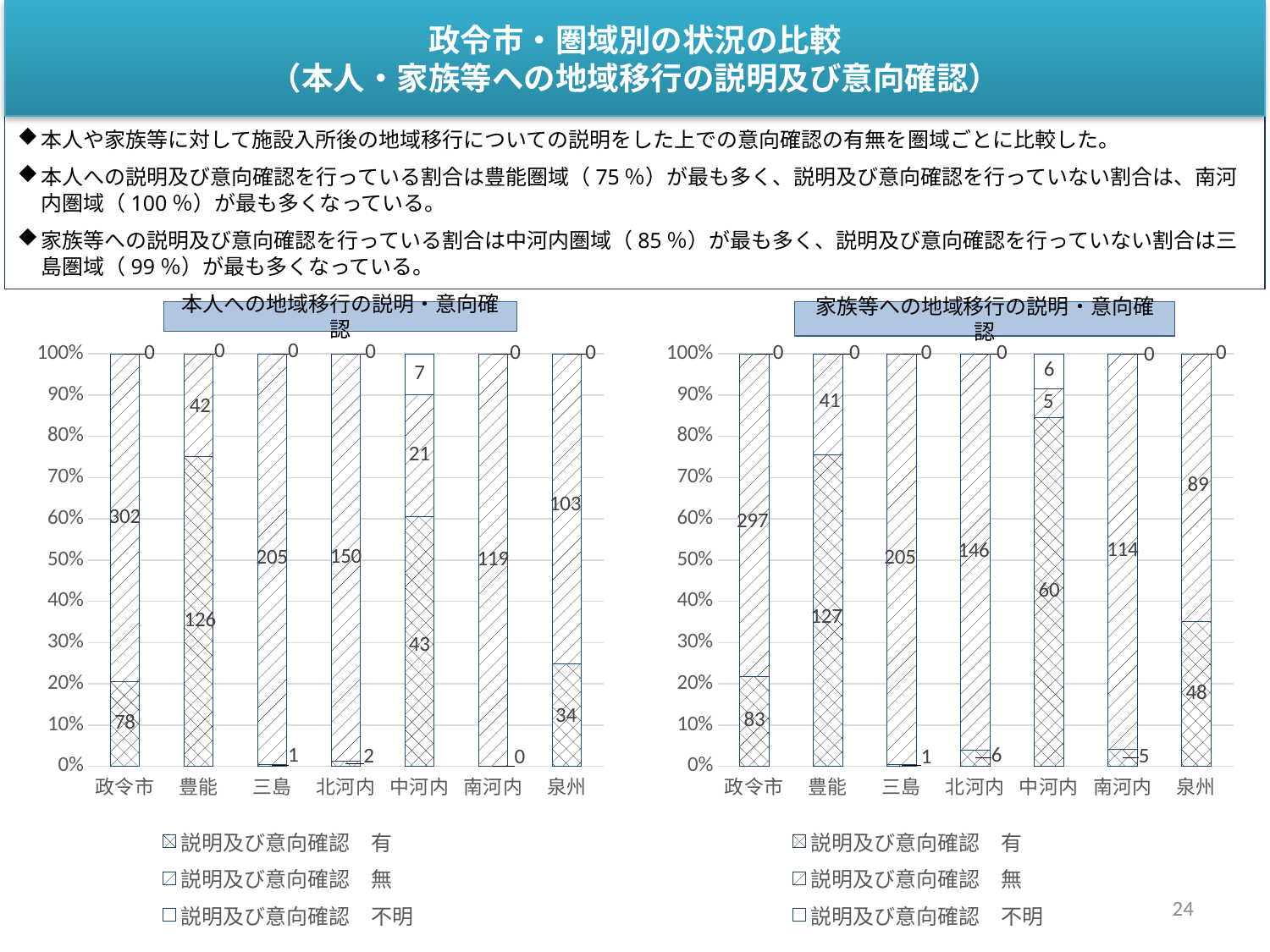
In the right chart (家族等への地域移行の説明・意向確認), what is the value of 説明及び意向確認 有 for 中河内? 60 In the left chart (本人への地域移行の説明・意向確認), which category has the highest value for 説明及び意向確認 無? 政令市 In the right chart (家族等への地域移行の説明・意向確認), what is the total of the stacked bar for 政令市? 380 In the left chart (本人への地域移行の説明・意向確認), what is the value of 説明及び意向確認 不明 for 中河内? 7 In the left chart (本人への地域移行の説明・意向確認), what is the value of 説明及び意向確認 有 for 政令市? 78 In the right chart (家族等への地域移行の説明・意向確認), what is the value of 説明及び意向確認 無 for 泉州? 89 In the left chart (本人への地域移行の説明・意向確認), which is larger for 中河内: 説明及び意向確認 有 or 説明及び意向確認 無? 説明及び意向確認 有 How many categories are shown on the x axis of the right chart (家族等への地域移行の説明・意向確認)? 7 In the left chart (本人への地域移行の説明・意向確認), what is the total of the stacked bar for 豊能? 168 In the left chart (本人への地域移行の説明・意向確認), what is the value of 説明及び意向確認 無 for 三島? 205 In the right chart (家族等への地域移行の説明・意向確認), what is the difference between 説明及び意向確認 無 and 説明及び意向確認 有 for 南河内? 109 How many series does the legend of the left chart (本人への地域移行の説明・意向確認) list? 3